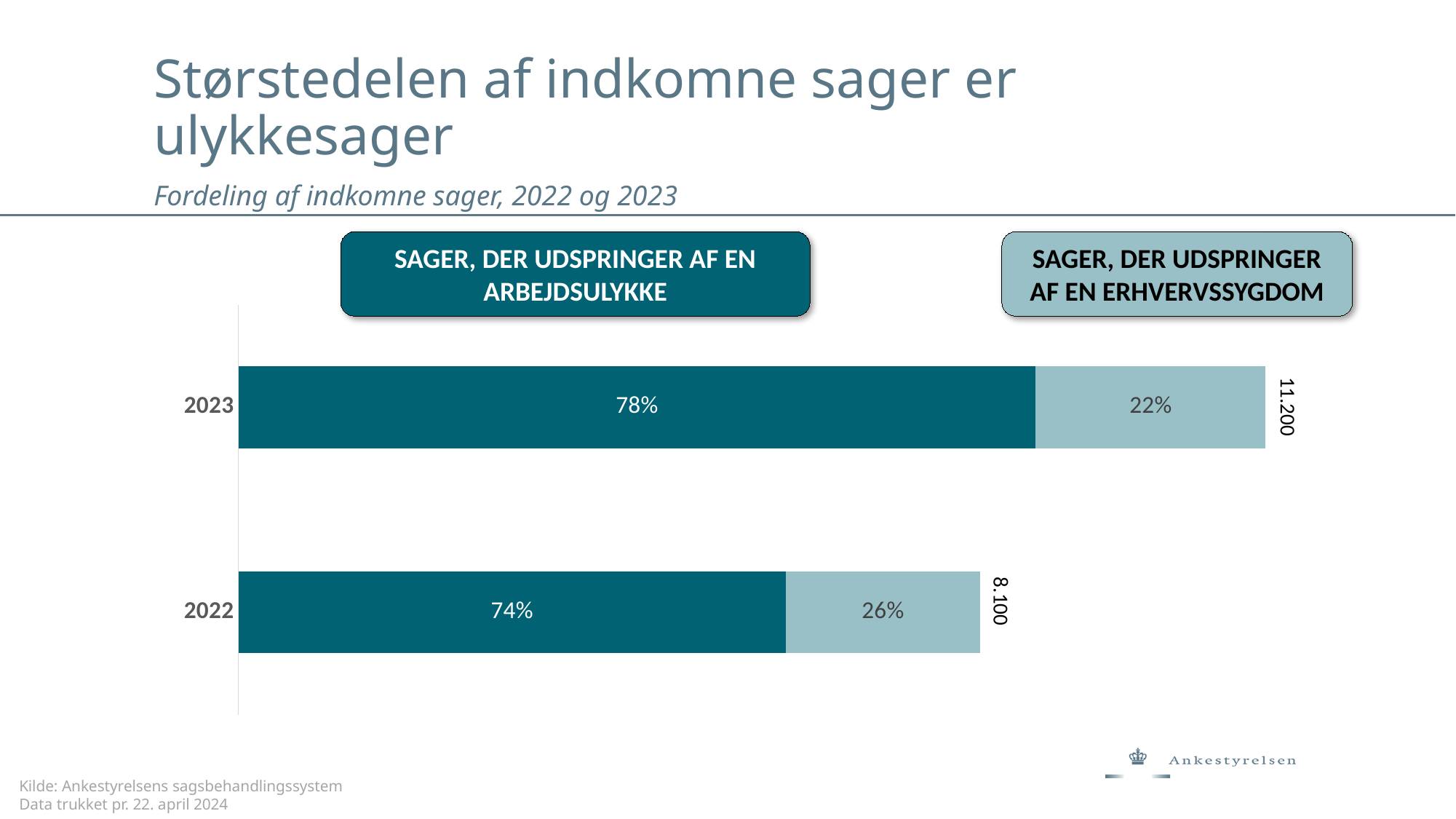
How many case categories (series) does the chart distinguish? 2 What share of incoming cases in 2023 stem from a work accident (arbejdsulykke)? 78% Which year has the higher share of occupational disease cases (erhvervssygdom), 2022 or 2023? 2022 What share of incoming cases in 2022 stem from an occupational disease (erhvervssygdom)? 26% What share of incoming cases in 2023 stem from an occupational disease (erhvervssygdom)? 22% By how many percentage points did the share of work accident cases (arbejdsulykke) change from 2022 to 2023? 4 percentage points Did the share of work accident cases (arbejdsulykke) rise or fall from 2022 to 2023? rise What total number of incoming cases is shown at the end of the 2022 bar? 8.100 How many years (bars) are shown in the chart? 2 What total number of incoming cases is shown at the end of the 2023 bar? 11.200 What type of chart is shown on the slide? stacked bar chart What share of incoming cases in 2022 stem from a work accident (arbejdsulykke)? 74%